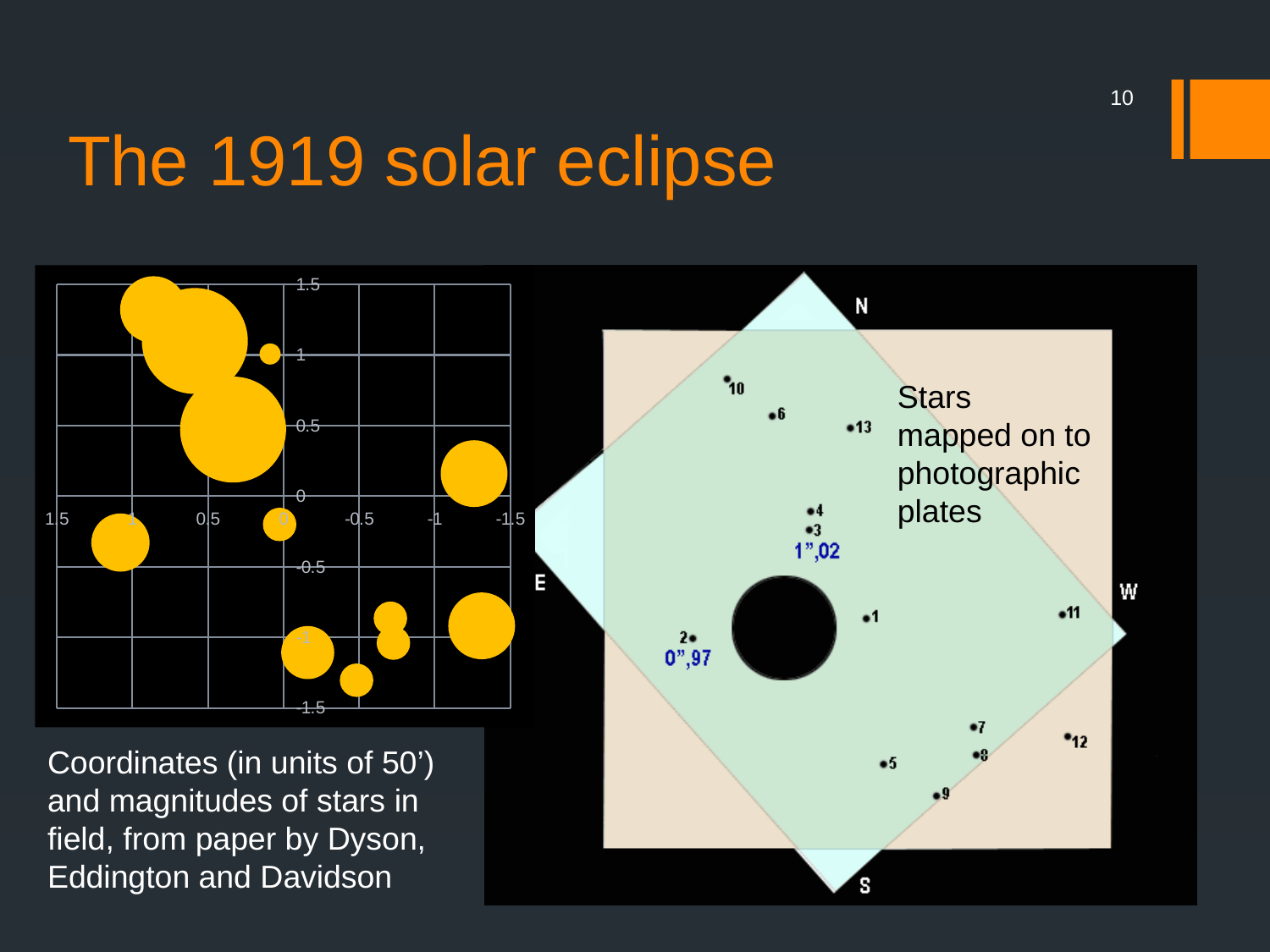
On the right diagram, what value is printed in blue next to star 2? 0",97 On the left chart, what is the lowest value labelled on the vertical axis? -1.5 What colour are the bubbles in the left chart? orange/yellow On the left chart, what is the highest value labelled on the vertical axis? 1.5 What kind of chart is shown on the left of the slide? bubble chart On the left chart, is the bubble at the far left of the plot (near x = 1) above or below 0 on the vertical axis? below According to the caption of the left chart, in what units are the star coordinates given? units of 50' On the right diagram, which of the two blue-labelled values is larger, the one at star 3 or the one at star 2? star 3 On the right diagram, what value is printed in blue next to star 3? 1",02 On the right diagram of the photographic plate, how many numbered stars are marked? 13